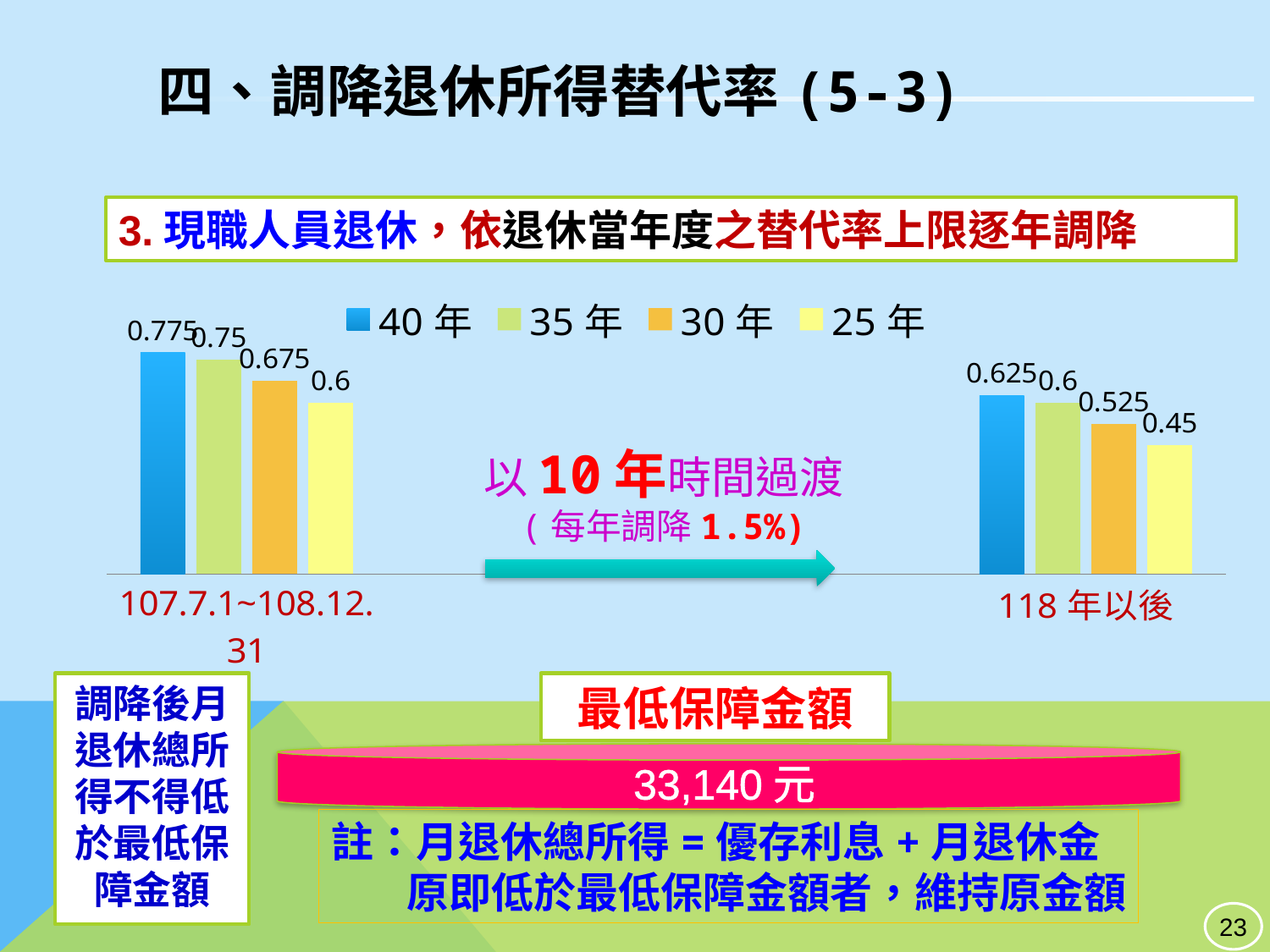
What kind of chart is shown on the slide? bar chart Which series has the lowest value in the 107.7.1~108.12.31 group? 25 年 What is the value for the 30 年 series in the 107.7.1~108.12.31 group? 0.675 What is the value for the 40 年 series in the 107.7.1~108.12.31 group? 0.775 Which is larger: the 30 年 value in the 107.7.1~108.12.31 group or the 30 年 value in the 118 年以後 group? 107.7.1~108.12.31 What is the value for the 35 年 series in the 118 年以後 group? 0.6 What is the difference between the 40 年 value in the 107.7.1~108.12.31 group and the 40 年 value in the 118 年以後 group? 0.15 Do the values for each series rise or fall from the 107.7.1~108.12.31 group to the 118 年以後 group? fall How many category groups are shown on the x axis? 2 What is the value for the 25 年 series in the 118 年以後 group? 0.45 Which series has the highest value in the 118 年以後 group? 40 年 How many series does the legend list? 4